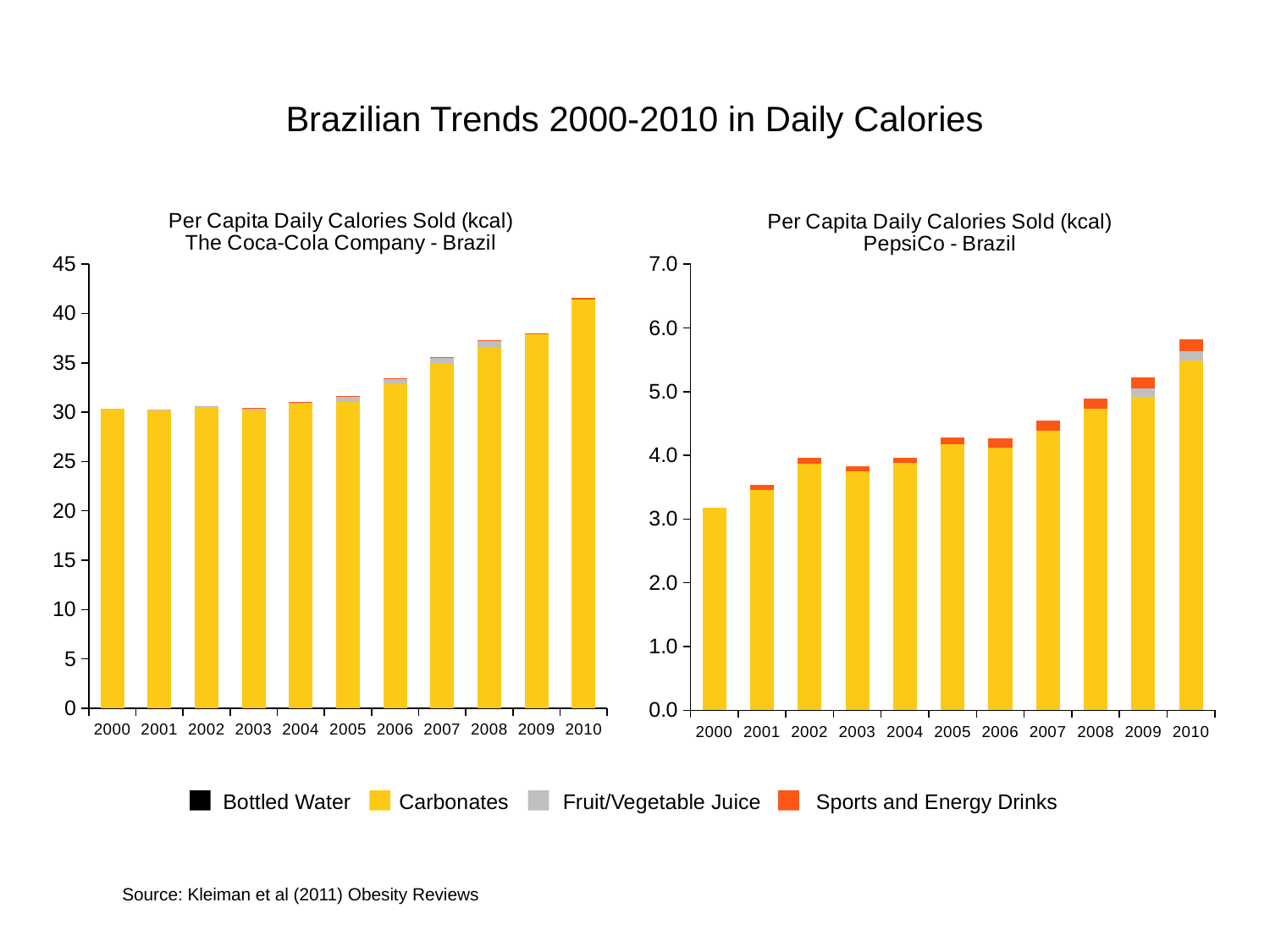
In the Coca-Cola Company - Brazil chart, which year has the highest total bar? 2010 In the PepsiCo - Brazil chart, which year has the larger total bar, 2002 or 2009? 2009 In the PepsiCo - Brazil chart, which year has the lowest total bar? 2000 What kind of chart is the Per Capita Daily Calories Sold (kcal) The Coca-Cola Company - Brazil chart? Stacked bar chart In the PepsiCo - Brazil chart, which year has the highest total bar? 2010 In the Coca-Cola Company - Brazil chart, is the total value for 2010 greater or less than 40? greater In the Coca-Cola Company - Brazil chart, do the total bars generally rise or fall from 2000 to 2010? Rise In the Coca-Cola Company - Brazil chart, is the total value for 2005 greater or less than 35? less How many years are shown on the x axis of the PepsiCo - Brazil chart? 11 In the PepsiCo - Brazil chart, is the total value for 2001 greater or less than 4.0? less How many series does the legend list? 4